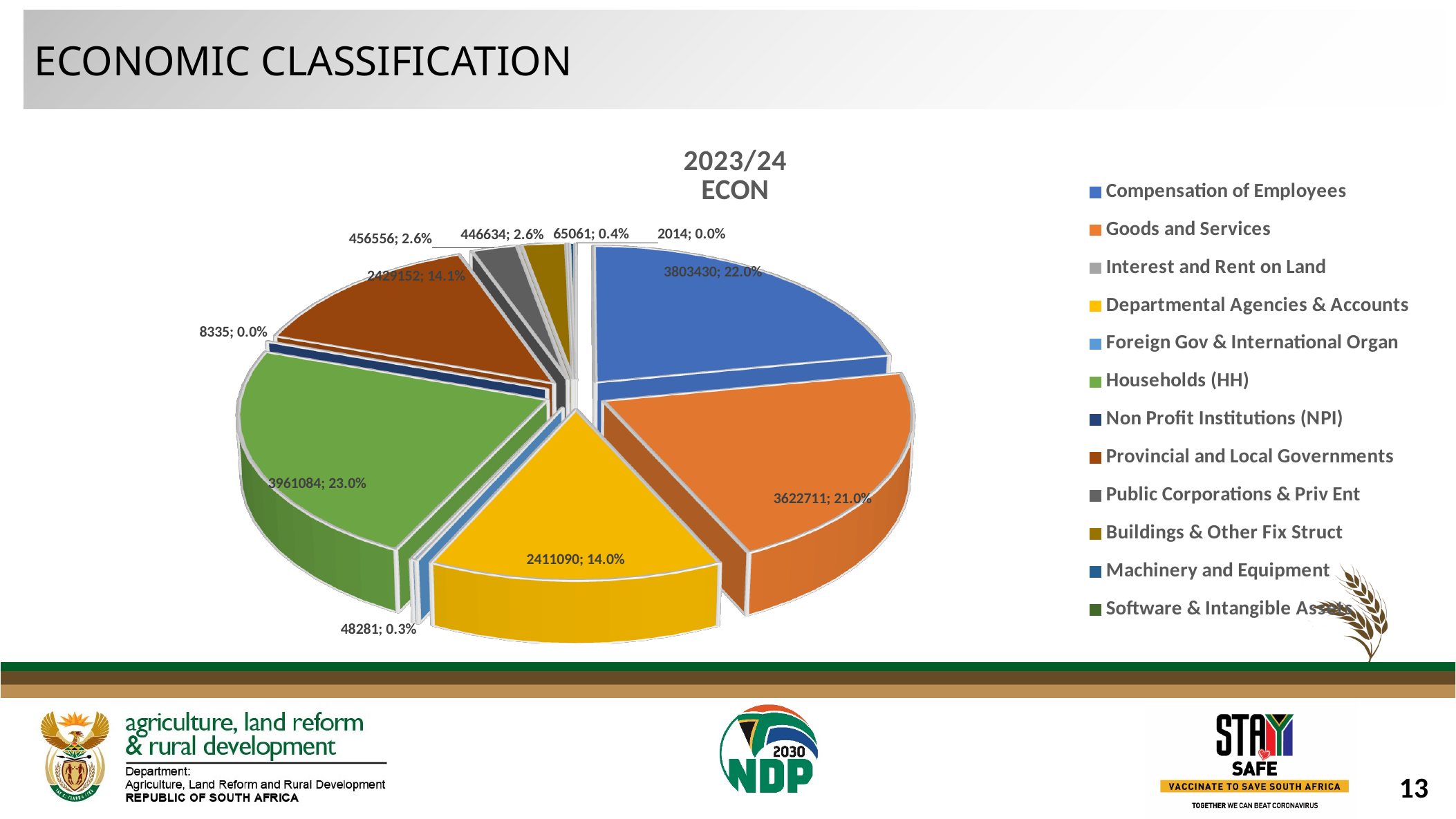
How many categories does the legend list? 12 What is the value shown for Foreign Gov & International Organ? 48281 What percentage is shown for Goods and Services? 21.0% What type of chart is shown on the slide? Pie chart What is the title of the chart? 2023/24 ECON Which is larger, the value for Compensation of Employees or the value for Goods and Services? Compensation of Employees Which category has the largest share of the pie? Households (HH) What is the difference between the values for Compensation of Employees and Goods and Services? 180719 What is the value shown for Departmental Agencies & Accounts? 2411090 What share of the pie does Households (HH) represent? 23.0% What is the value shown for Compensation of Employees? 3803430 What percentage is shown for Provincial and Local Governments? 14.1%